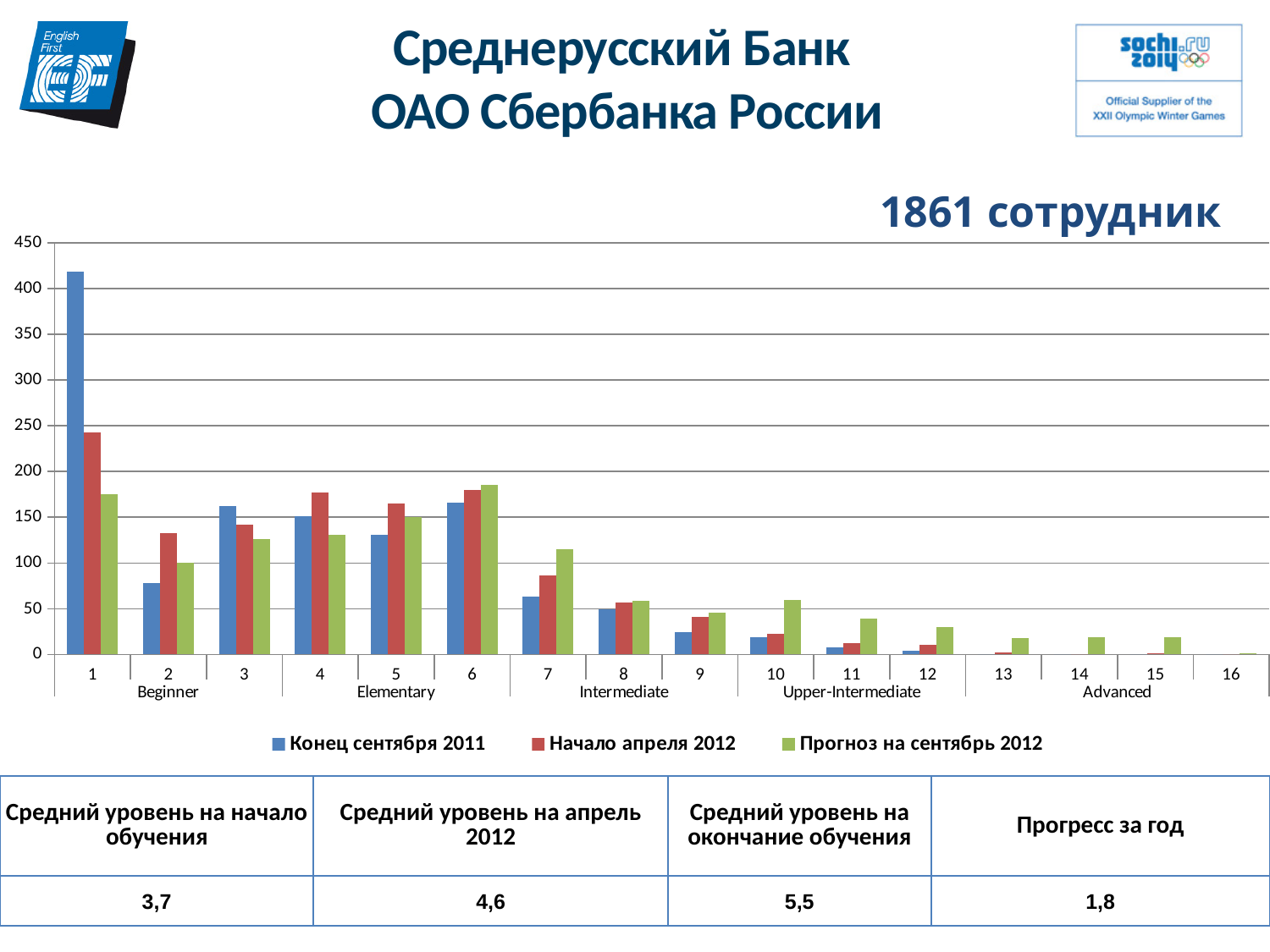
Is the value for level 1 in the series 'Начало апреля 2012' greater or less than 200? greater At level 7, which series has the larger value: 'Конец сентября 2011' or 'Прогноз на сентябрь 2012'? Прогноз на сентябрь 2012 Which level has the highest value for the series 'Конец сентября 2011'? 1 How many series does the chart legend list? 3 What kind of chart is shown on the slide? bar chart How many named proficiency groups (such as Beginner, Elementary) are labelled under the x axis of the chart? 5 At level 2, which series has the larger value: 'Конец сентября 2011' or 'Начало апреля 2012'? Начало апреля 2012 Is the value for level 7 in the series 'Прогноз на сентябрь 2012' greater or less than 100? greater Is the value for level 1 in the series 'Конец сентября 2011' greater or less than 400? greater How many numbered levels are shown along the x axis of the chart? 16 From level 7 to level 12, does the series 'Конец сентября 2011' rise or fall? fall